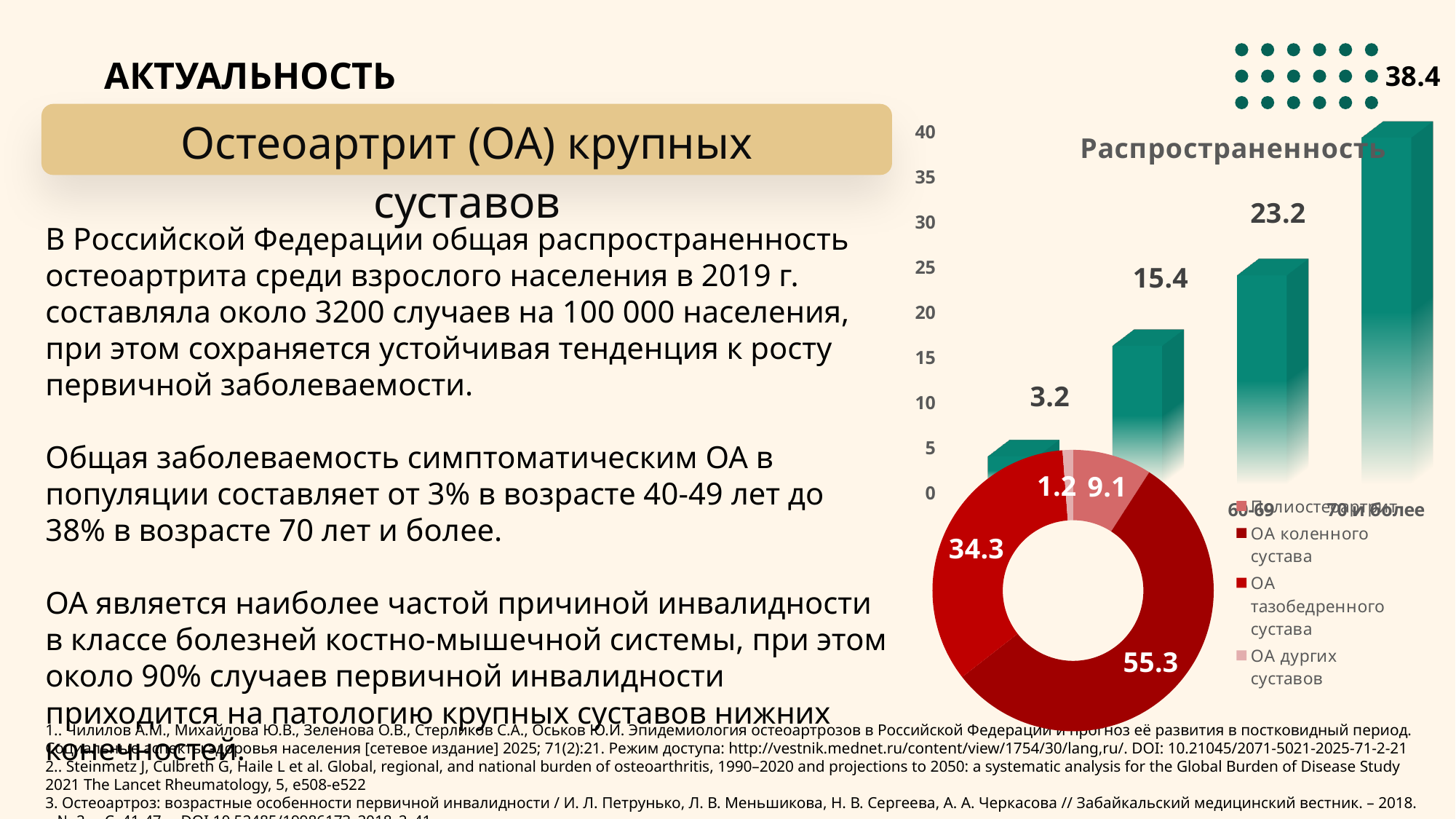
On the bar chart titled «Распространенность», what is the lowest value shown? 3.2 On the bar chart titled «Распространенность», what is the difference between the highest and lowest bar values? 35.2 On the bar chart titled «Распространенность», what is the value for the «70 и более» age group? 38.4 On the donut chart at the bottom right, what is the value of the smallest slice? 1.2 On the bar chart titled «Распространенность», how many bars are plotted? 4 On the bar chart titled «Распространенность», do the values rise or fall from left to right? rise What kind of chart is the chart titled «Распространенность»? bar chart How many entries does the legend of the donut chart at the bottom right list? 4 On the donut chart at the bottom right, what is the difference between the two largest slices (55.3 and 34.3)? 21 On the bar chart titled «Распространенность», what is the highest value shown? 38.4 On the bar chart titled «Распространенность», what is the value for the «60-69» age group? 23.2 On the donut chart at the bottom right, what is the value of the largest slice? 55.3